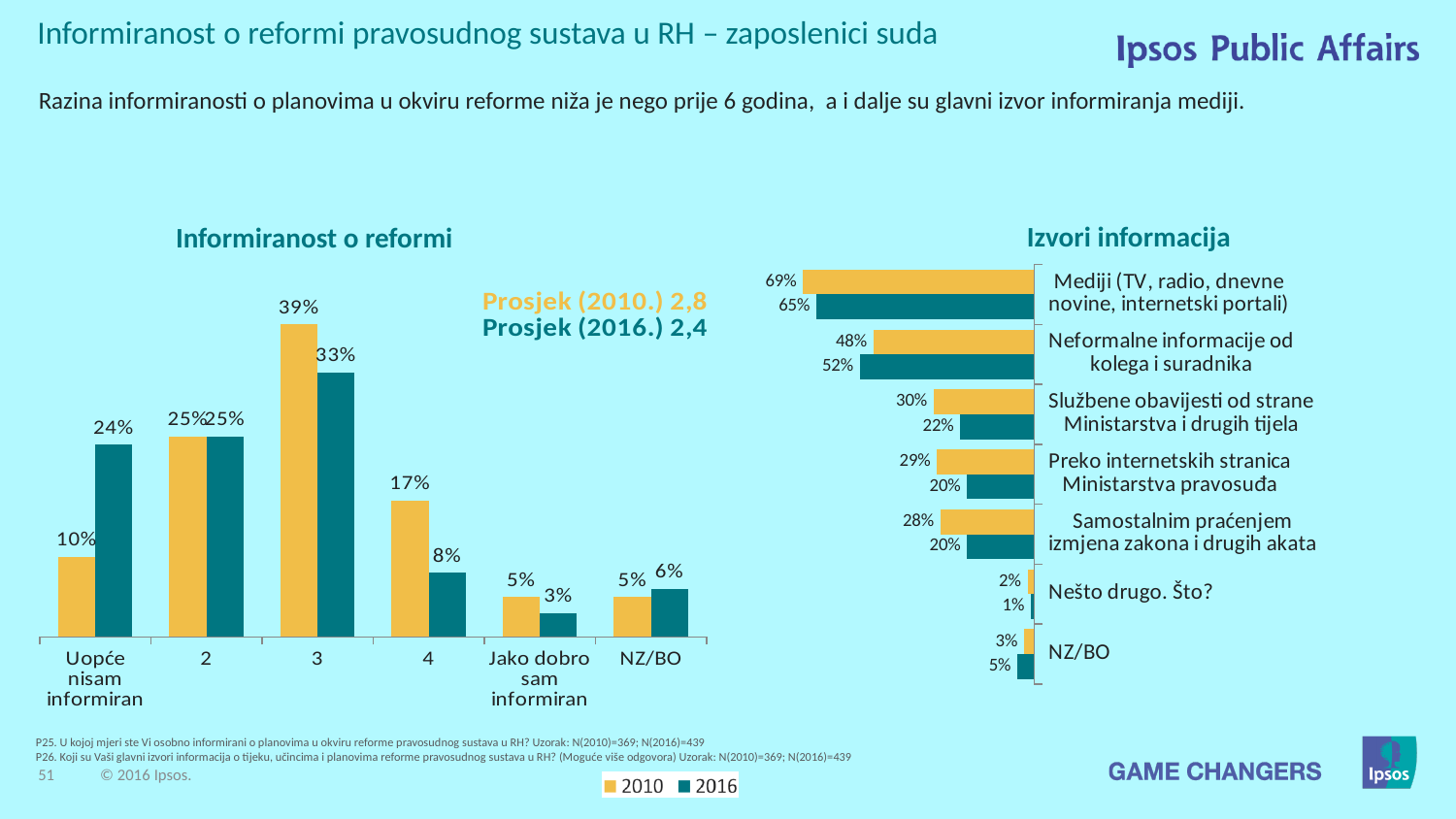
How many series does the legend list? 2 In the 'Izvori informacija' chart, what is the 2010 value for 'Mediji (TV, radio, dnevne novine, internetski portali)'? 69% In the 'Izvori informacija' chart, which category has the lowest 2016 value? Nešto drugo. Što? In the 'Informiranost o reformi' chart, what is the difference between the 2010 and 2016 values for category 4? 9% In the 'Informiranost o reformi' chart, what is the 2010 value for category 3? 39% In the 'Izvori informacija' chart, what is the 2016 value for 'Neformalne informacije od kolega i suradnika'? 52% In the 'Informiranost o reformi' chart, what is the 2016 value for 'Uopće nisam informiran'? 24% In the 'Informiranost o reformi' chart, which category has the highest 2010 value? 3 In the 'Informiranost o reformi' chart, how many categories are shown on the x axis? 6 In the 'Izvori informacija' chart, is the 2010 value for 'Službene obavijesti od strane Ministarstva i drugih tijela' larger or the 2016 value? 2010 What kind of chart is 'Izvori informacija'? Bar chart In the 'Izvori informacija' chart, what is the difference between the 2010 and 2016 values for 'Preko internetskih stranica Ministarstva pravosuđa'? 9%